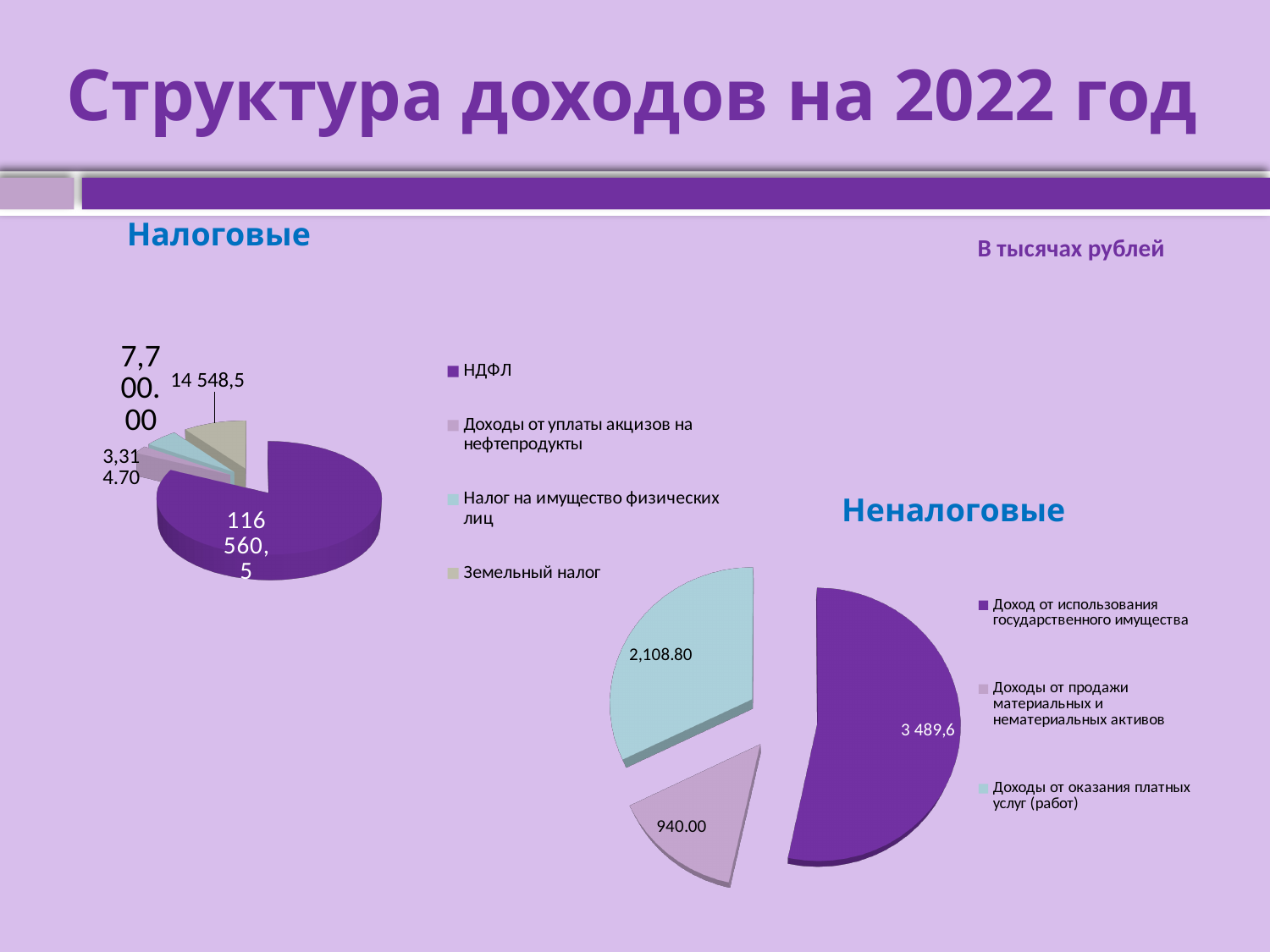
In the Неналоговые chart, what is the value for Доходы от оказания платных услуг (работ)? 2,108.80 What type of chart is used for the Налоговые revenues? pie chart In the Неналоговые chart, which is larger: Доходы от оказания платных услуг (работ) or Доходы от продажи материальных и нематериальных активов? Доходы от оказания платных услуг (работ) In the Неналоговые chart, what is the value for Доходы от продажи материальных и нематериальных активов? 940.00 In the Налоговые chart, which category has the smallest slice? Доходы от уплаты акцизов на нефтепродукты In the Налоговые chart, which category has the largest slice? НДФЛ How many categories does the legend of the Налоговые chart list? 4 In the Неналоговые chart, which category has the smallest slice? Доходы от продажи материальных и нематериальных активов In the Налоговые chart, what is the value for НДФЛ? 116 560,5 In the Неналоговые chart, what is the value for Доход от использования государственного имущества? 3 489,6 In the Неналоговые chart, what is the difference between Доходы от оказания платных услуг (работ) and Доходы от продажи материальных и нематериальных активов? 1,168.80 In the Налоговые chart, what is the value for Земельный налог? 14 548,5